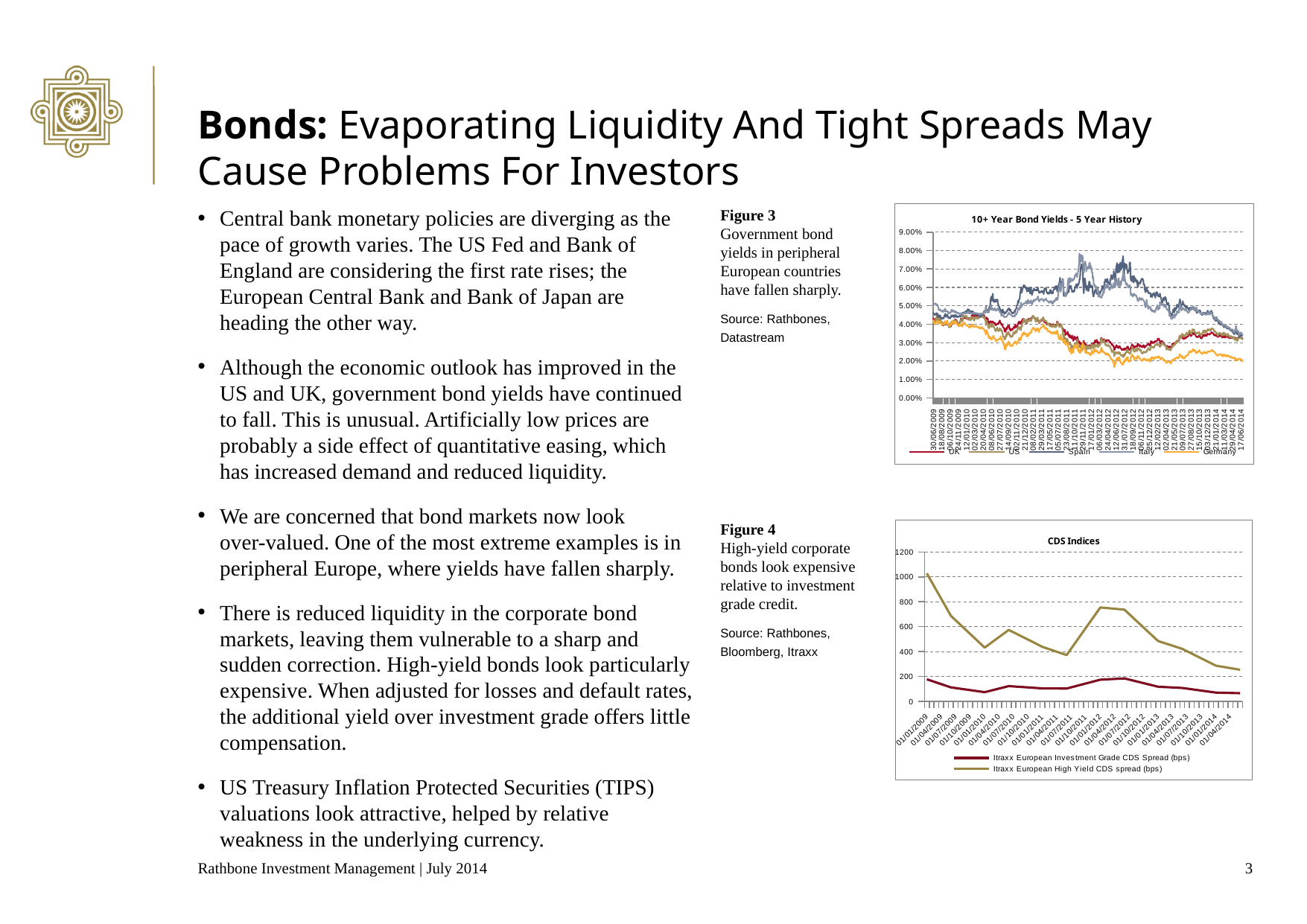
In the 'CDS Indices' chart, does the Itraxx European High Yield CDS spread rise or fall overall from 01/01/2009 to 01/04/2014? fall In the 'CDS Indices' chart, is the value of the Itraxx European High Yield CDS spread at 01/01/2009 greater or less than 800? greater What is the title of the lower chart on the slide? CDS Indices How many series does the legend of the '10+ Year Bond Yields - 5 Year History' chart list? 5 What kind of chart is the '10+ Year Bond Yields - 5 Year History' chart? line chart How many series does the legend of the 'CDS Indices' chart list? 2 In the '10+ Year Bond Yields - 5 Year History' chart, is the Germany yield at the end of the period (2014) greater or less than 3.00%? less In the 'CDS Indices' chart, is the Itraxx European Investment Grade CDS Spread at 01/04/2014 greater or less than 200? less What kind of chart is the 'CDS Indices' chart? line chart What is the title of the upper chart on the slide? 10+ Year Bond Yields - 5 Year History In the 'CDS Indices' chart, which series is higher throughout the period, Itraxx European High Yield CDS spread or Itraxx European Investment Grade CDS Spread? Itraxx European High Yield CDS spread